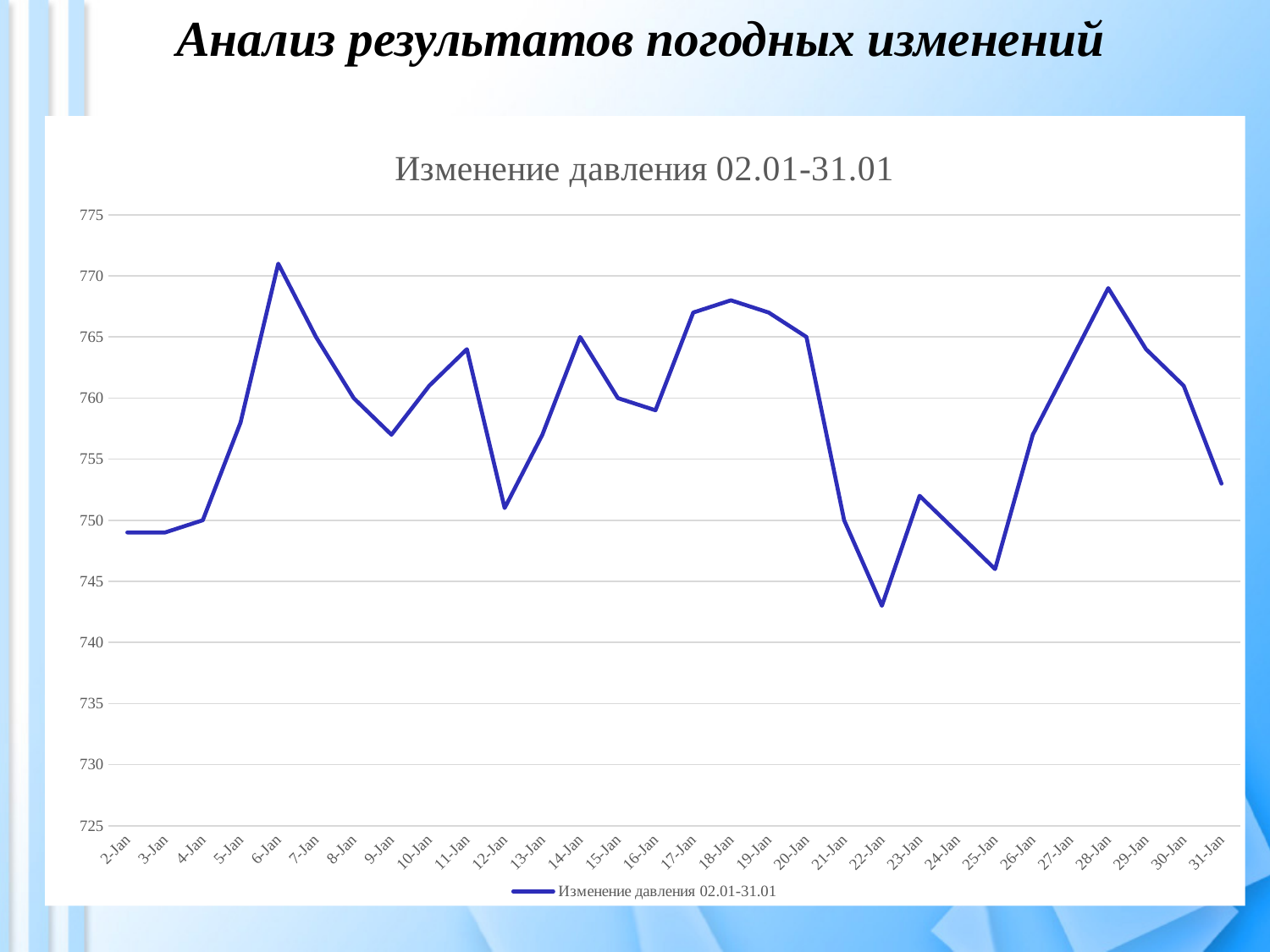
What kind of chart is shown on the slide? line chart Is the value for 28-Jan greater or less than 765? greater Is the value for 22-Jan greater or less than 745? less Is the value for 6-Jan greater or less than 765? greater On which date is the pressure highest? 6-Jan Which date has the higher pressure, 18-Jan or 11-Jan? 18-Jan What is the title of the chart? Изменение давления 02.01-31.01 How many dates are plotted along the x axis? 30 How many series does the legend list? 1 On which date is the pressure lowest? 22-Jan Does the pressure rise or fall from 2-Jan to 6-Jan? rise